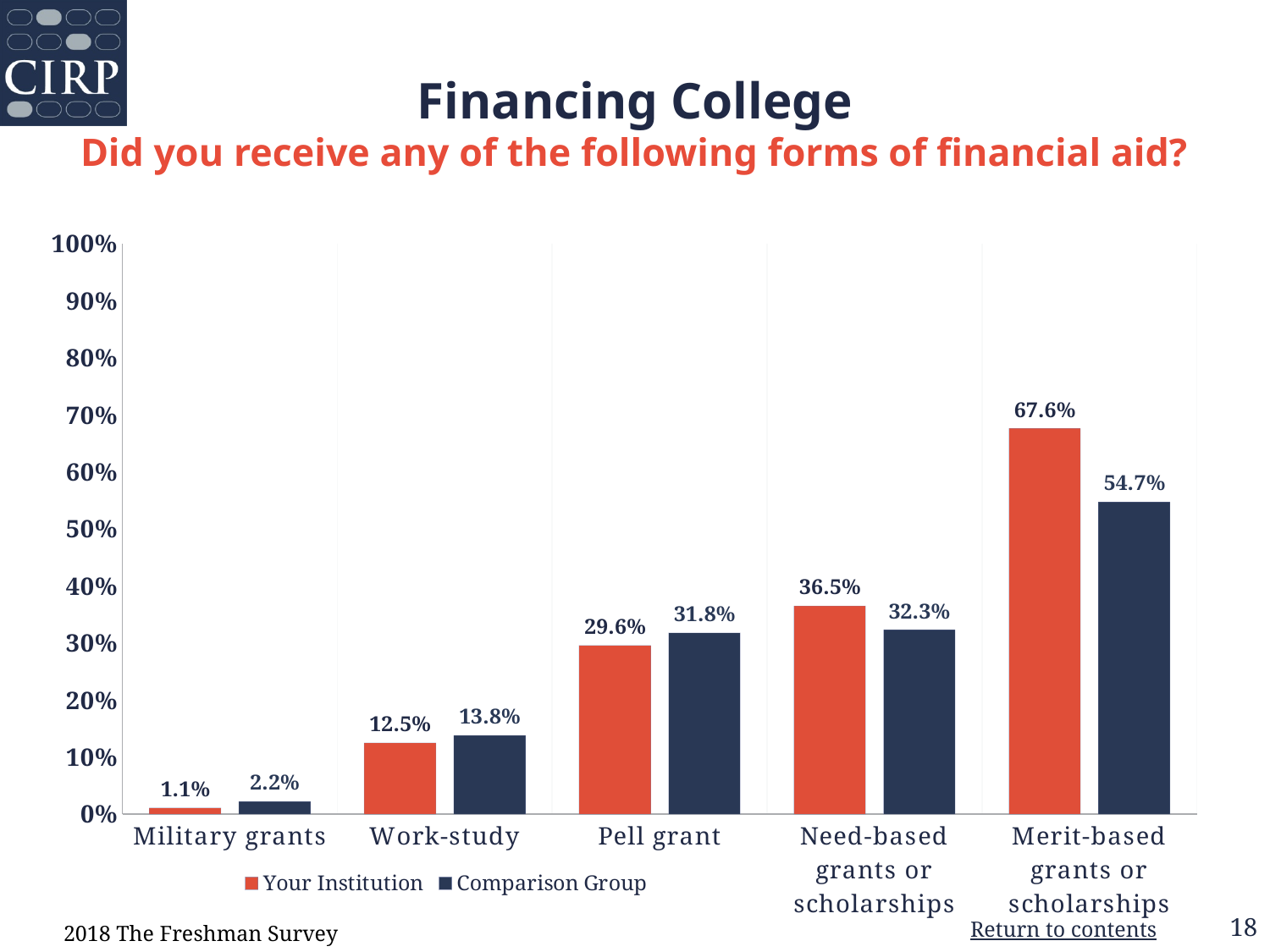
How many forms of financial aid are shown on the x axis? 5 What is the difference between the Comparison Group and Your Institution for Military grants? 1.1% For Need-based grants or scholarships, which series has the larger value, Your Institution or Comparison Group? Your Institution How many series does the legend list? 2 For Pell grant, which series has the larger value, Your Institution or Comparison Group? Comparison Group What is the Your Institution value for Work-study? 12.5% What kind of chart is shown on the slide? Bar chart Which form of financial aid has the lowest value for the Comparison Group? Military grants What is the Comparison Group value for Merit-based grants or scholarships? 54.7% What is the difference between Your Institution and the Comparison Group for Merit-based grants or scholarships? 12.9% Which form of financial aid has the highest value for Your Institution? Merit-based grants or scholarships What percentage of Your Institution students received a Pell grant? 29.6%